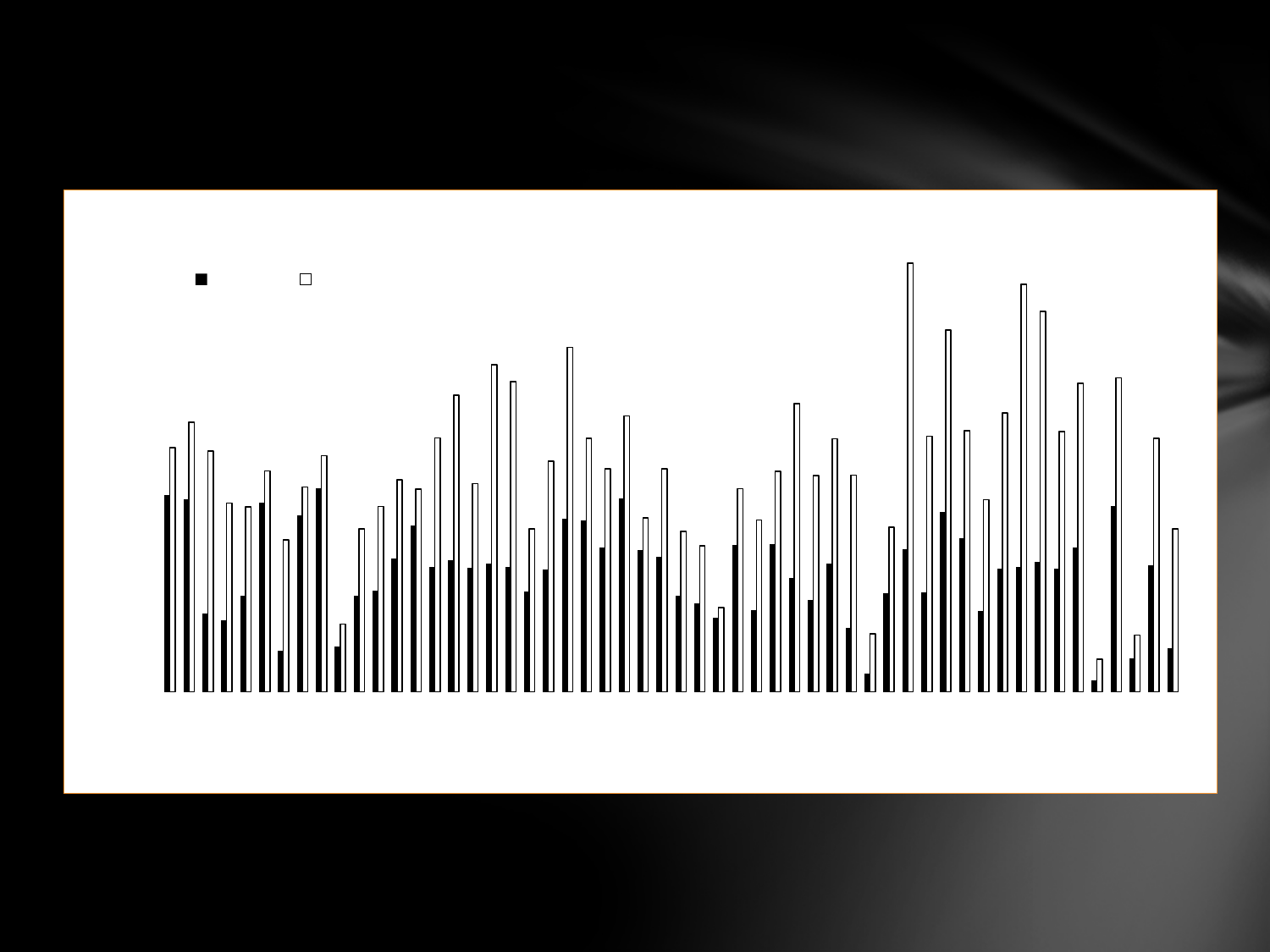
What colours are used for the two series in the chart? black and white What kind of chart is shown on the slide? bar chart Which series contains the tallest bar in the chart, the black series or the white series? the white series How many series does the legend show? 2 Are the bars in the chart vertical or horizontal? vertical